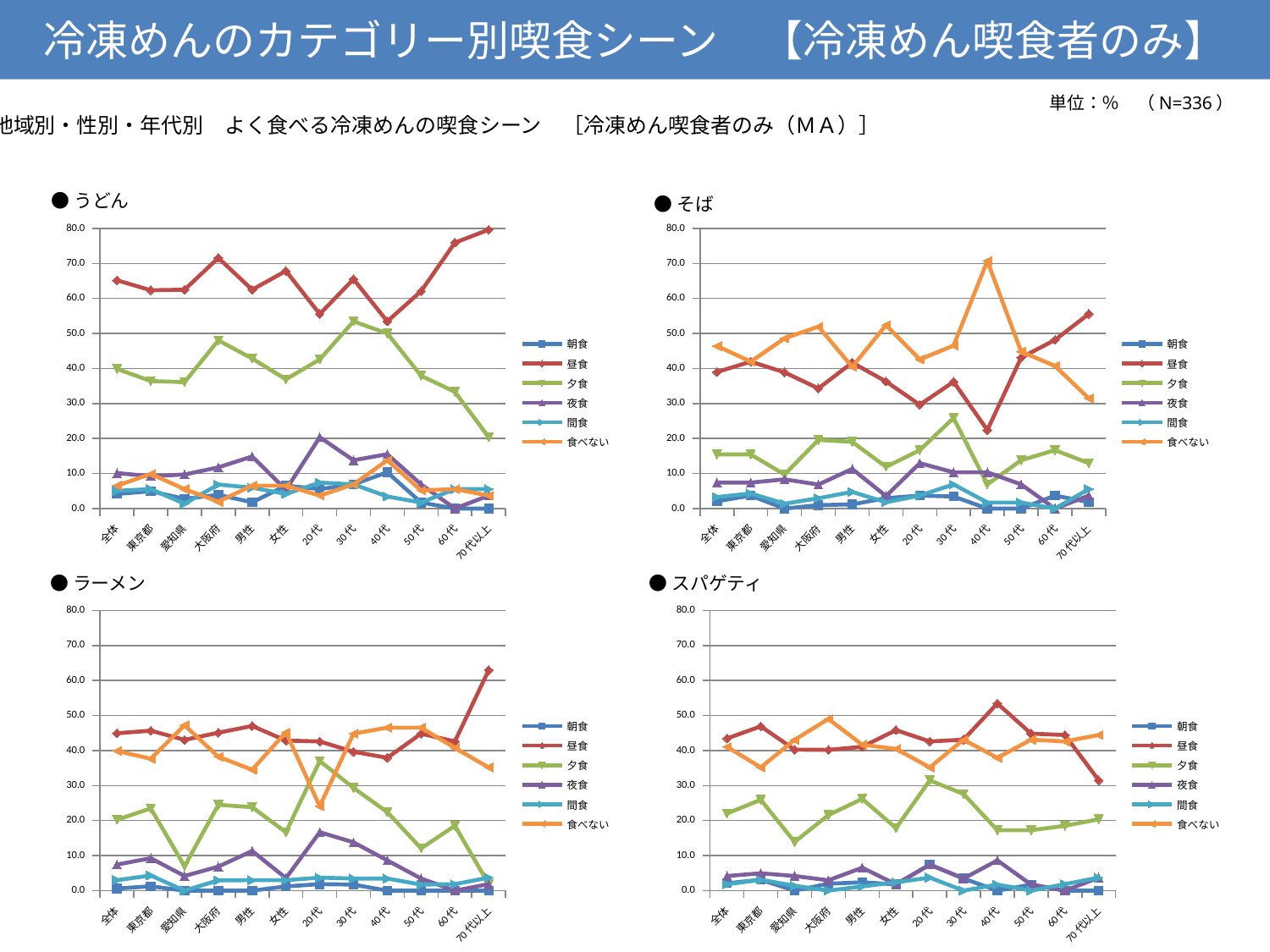
In the ラーメン chart, is the 夕食 value for 愛知県 greater or less than 10? less In the うどん chart, how many categories are shown along the x axis? 12 In the うどん chart, how many series does the legend list? 6 In the そば chart, which category has the highest 食べない value? 40代 In the ラーメン chart, which category has the highest 昼食 value? 70代以上 What kind of chart is the うどん chart at the top left? line chart In the うどん chart, which category has the highest 昼食 value? 70代以上 In the うどん chart, is the 昼食 value for 全体 greater or less than 60? greater In the そば chart, is the 昼食 value for 40代 greater or less than 30? less In the うどん chart, does the 夕食 line rise or fall from 40代 to 70代以上? fall In the スパゲティ chart, for 70代以上, which is larger: 昼食 or 食べない? 食べない